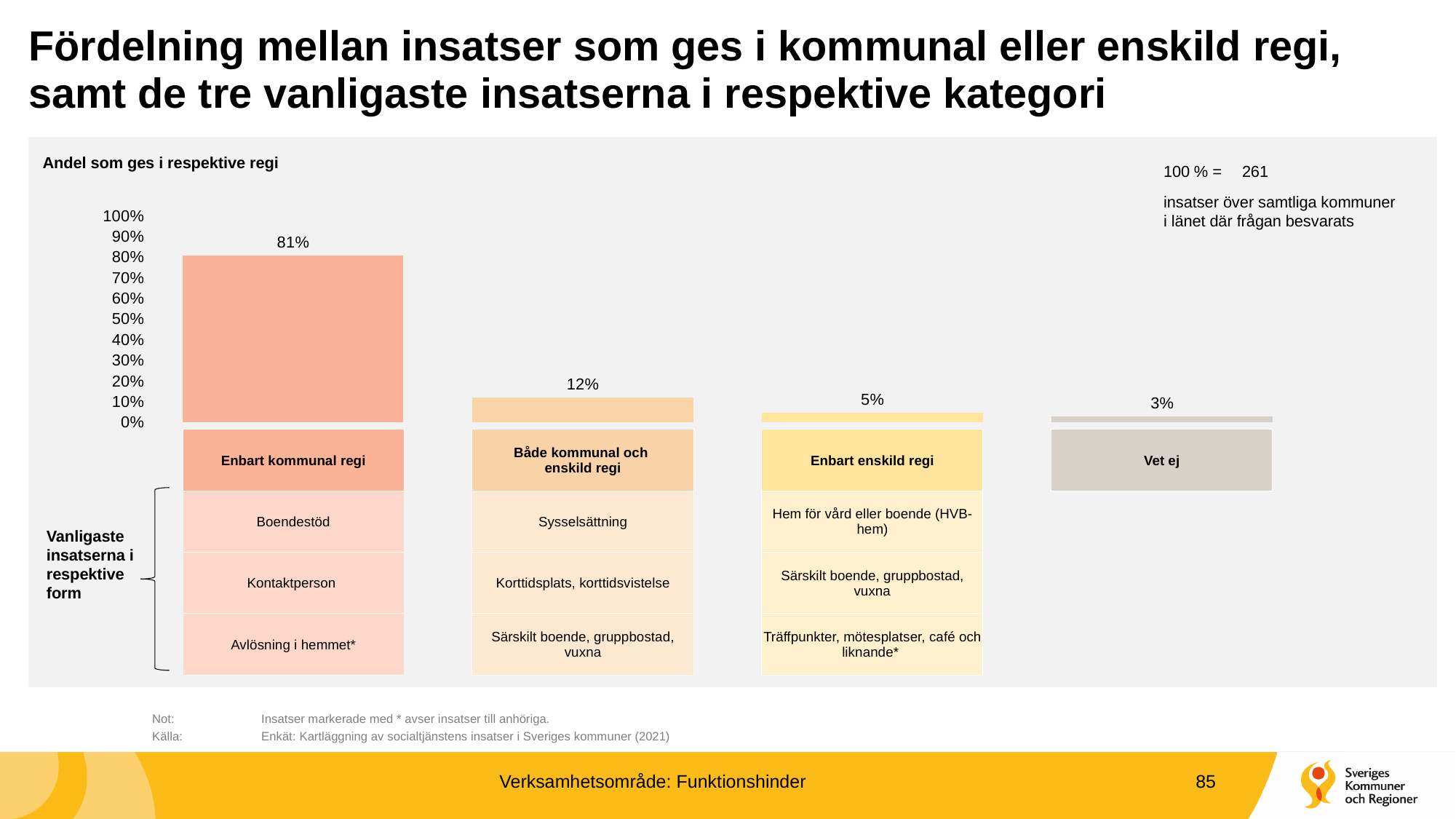
Which category has the lowest value? Vet ej What total number of insatser does 100% correspond to, according to the note on the slide? 261 Which is larger, the value for "Enbart enskild regi" or the value for "Vet ej"? Enbart enskild regi Is the value for "Enbart kommunal regi" greater or less than 50%? greater What is the value for "Enbart enskild regi"? 5% What is the value for "Enbart kommunal regi"? 81% How many categories are shown in the chart? 4 What is the value for "Både kommunal och enskild regi"? 12% What is the value for "Vet ej"? 3% What kind of chart is shown on the slide? bar chart What is the difference between the values for "Enbart kommunal regi" and "Både kommunal och enskild regi"? 69% Which category has the highest value? Enbart kommunal regi